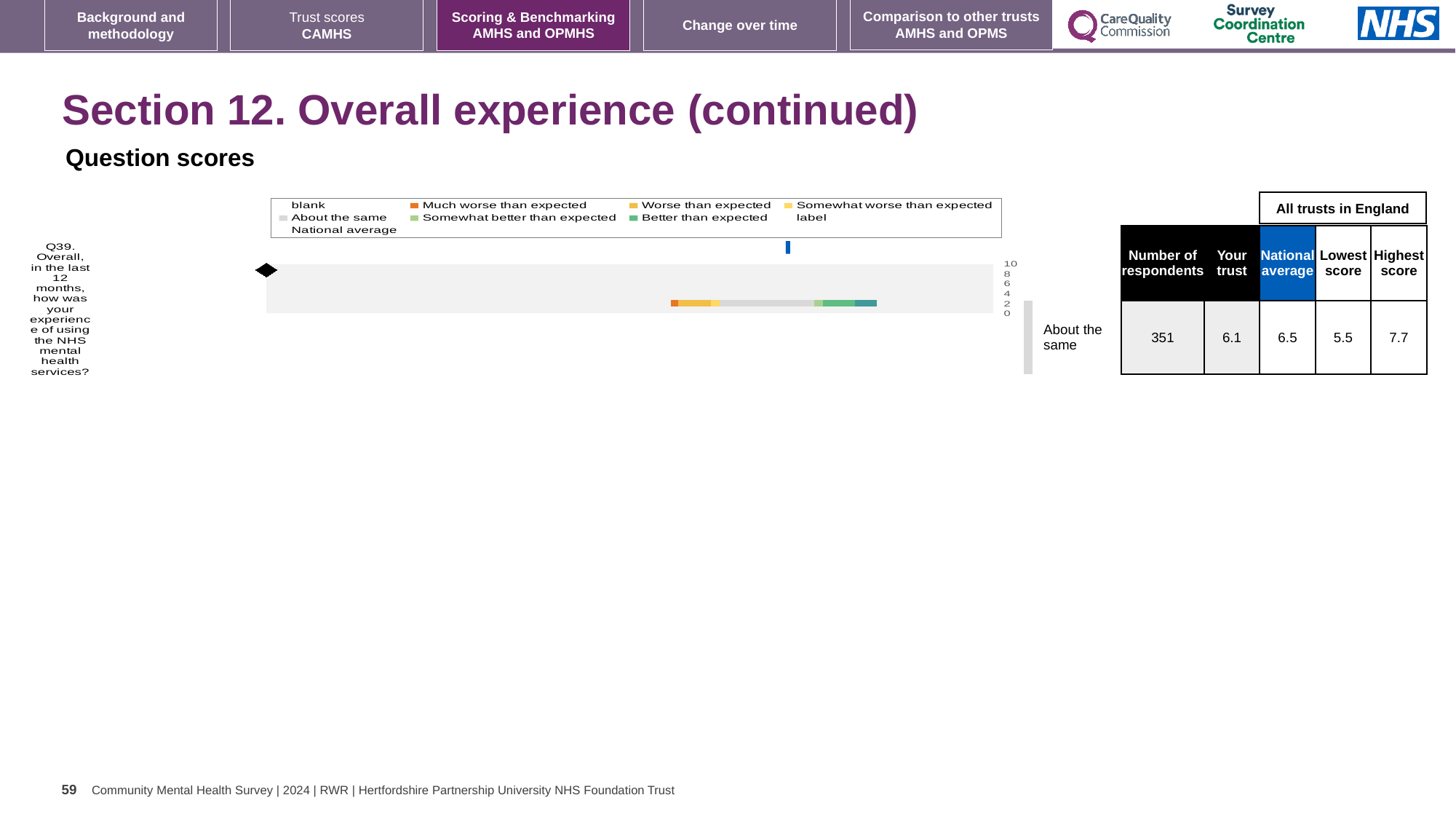
What is the highest score among all trusts in England for Q39? 7.7 How many questions are plotted in the question scores chart? 1 By how much does the national average exceed the trust's score for Q39? 0.4 What kind of chart is used to show the Q39 question score? bar chart How many entries does the legend of the question scores chart list? 9 Is the trust's score for Q39 higher or lower than the national average? lower Which benchmark category is the trust's Q39 score placed in? About the same What is the national average score for Q39? 6.5 What is the 'Your trust' score for Q39? 6.1 What is the lowest score among all trusts in England for Q39? 5.5 What is the difference between the highest and lowest scores for Q39? 2.2 How many respondents answered Q39? 351